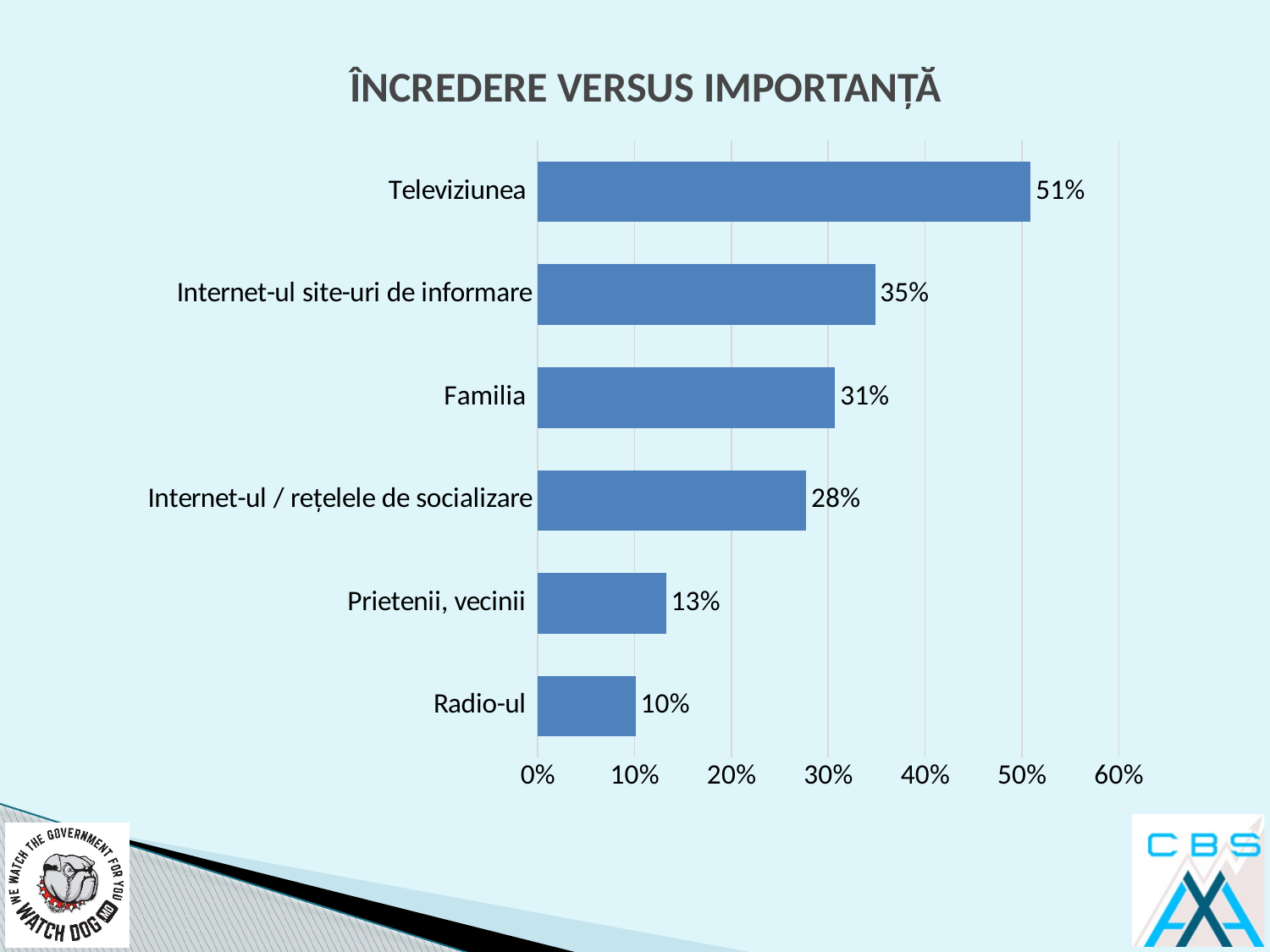
Which is larger, the value for Familia or the value for Internet-ul / rețelele de socializare? Familia What is the value for Familia? 31% How many categories are shown in the chart? 6 Which category has the lowest value? Radio-ul What is the difference between the values for Televiziunea and Internet-ul site-uri de informare? 16% What kind of chart is shown on the slide? Bar chart What is the value for Televiziunea? 51% Which category has the highest value? Televiziunea What is the difference between the values for Prietenii, vecinii and Radio-ul? 3% What is the value for Internet-ul / rețelele de socializare? 28% What is the value for Radio-ul? 10% What is the title of the chart? ÎNCREDERE VERSUS IMPORTANȚĂ